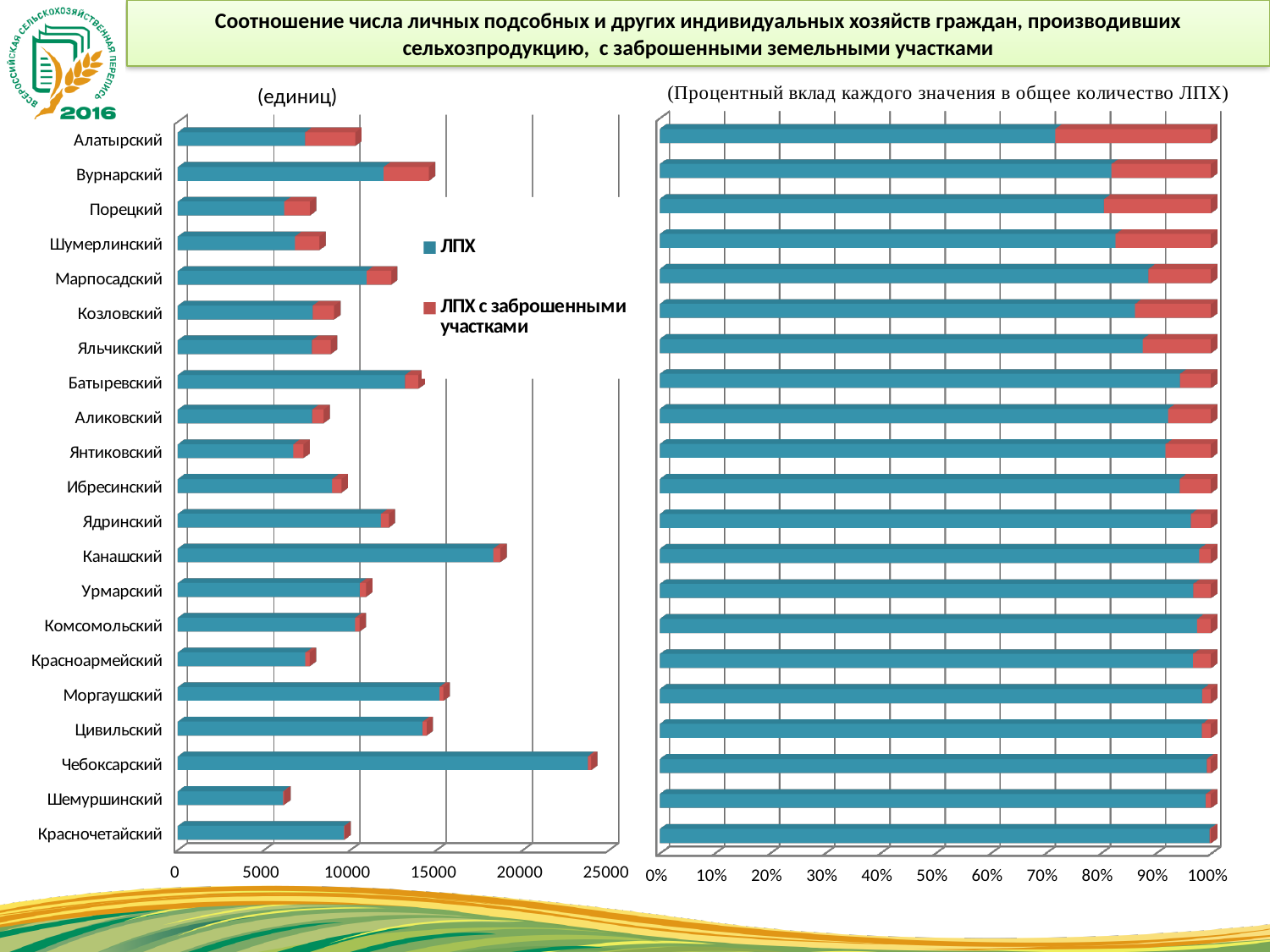
On the left chart "(единиц)", which district has the larger ЛПХ value, Канашский or Моргаушский? Канашский What is the maximum value shown on the horizontal axis of the right chart? 100% On the left chart "(единиц)", which district has the larger ЛПХ value, Вурнарский or Порецкий? Вурнарский How many categories (districts) are shown on the left chart "(единиц)"? 21 On the left chart "(единиц)", is the ЛПХ value for Красноармейский greater or less than 10000? less On the left chart "(единиц)", is the ЛПХ value for Канашский greater or less than 15000? greater What is the name of the second series in the legend of the left chart? ЛПХ с заброшенными участками What kind of chart is the left chart titled "(единиц)"? bar chart How many series does the legend on the left chart list? 2 On the left chart "(единиц)", is the ЛПХ value for Батыревский greater or less than 10000? greater On the left chart "(единиц)", which district has the highest ЛПХ value? Чебоксарский